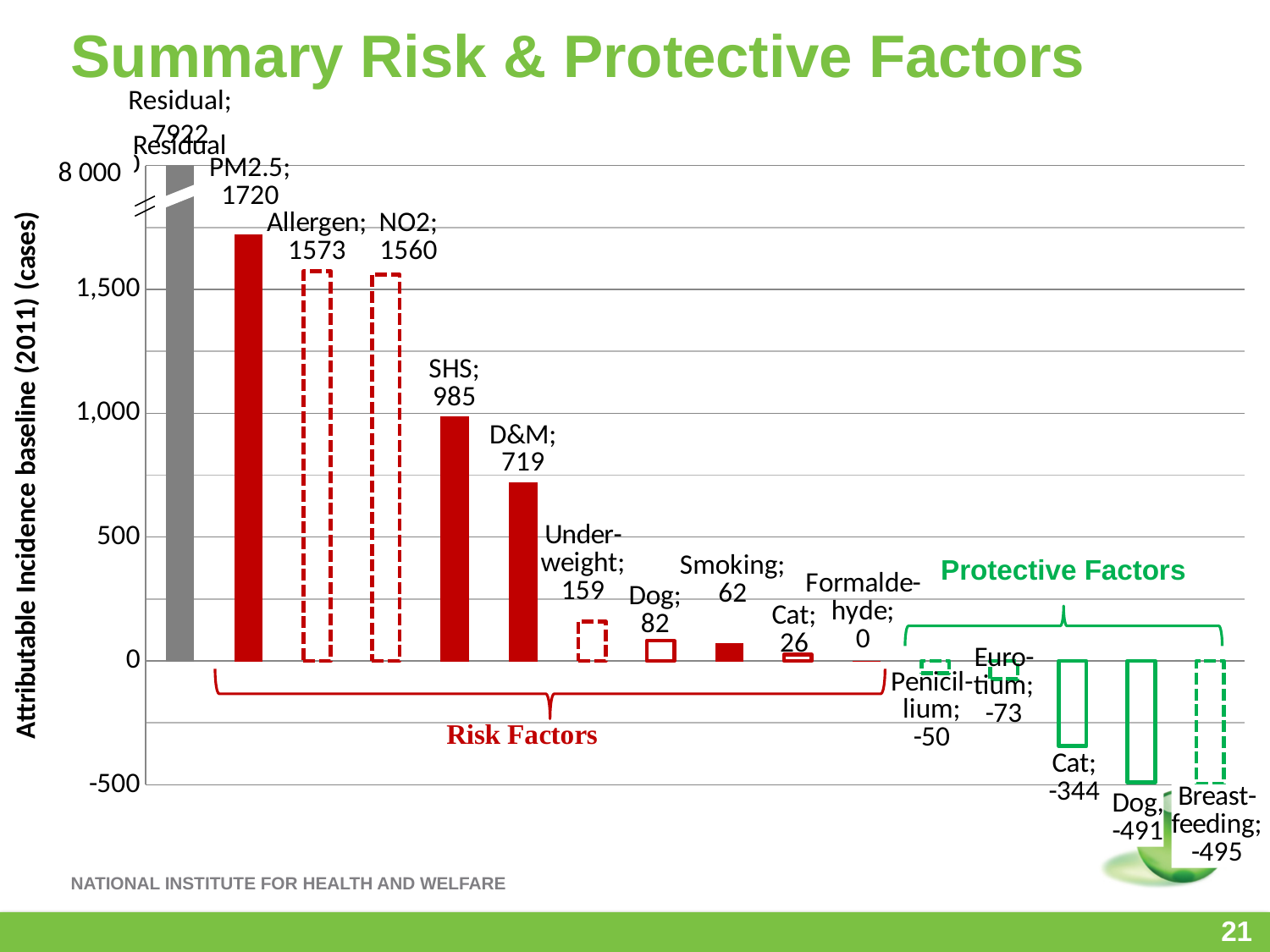
What kind of chart is shown on the slide? bar chart What is the value for Formaldehyde? 0 Which category has the highest value? Residual What is the value for PM2.5? 1720 What is the title of the vertical axis? Attributable Incidence baseline (2011) (cases) What is the value for Breast-feeding? -495 Is the value for D&M greater or less than 500? greater What is the value for Residual? 7922 Which is larger, the value for Allergen or the value for NO2? Allergen What is the difference between the values for PM2.5 and SHS? 735 What is the value for SHS? 985 Which category has the lowest value? Breast-feeding